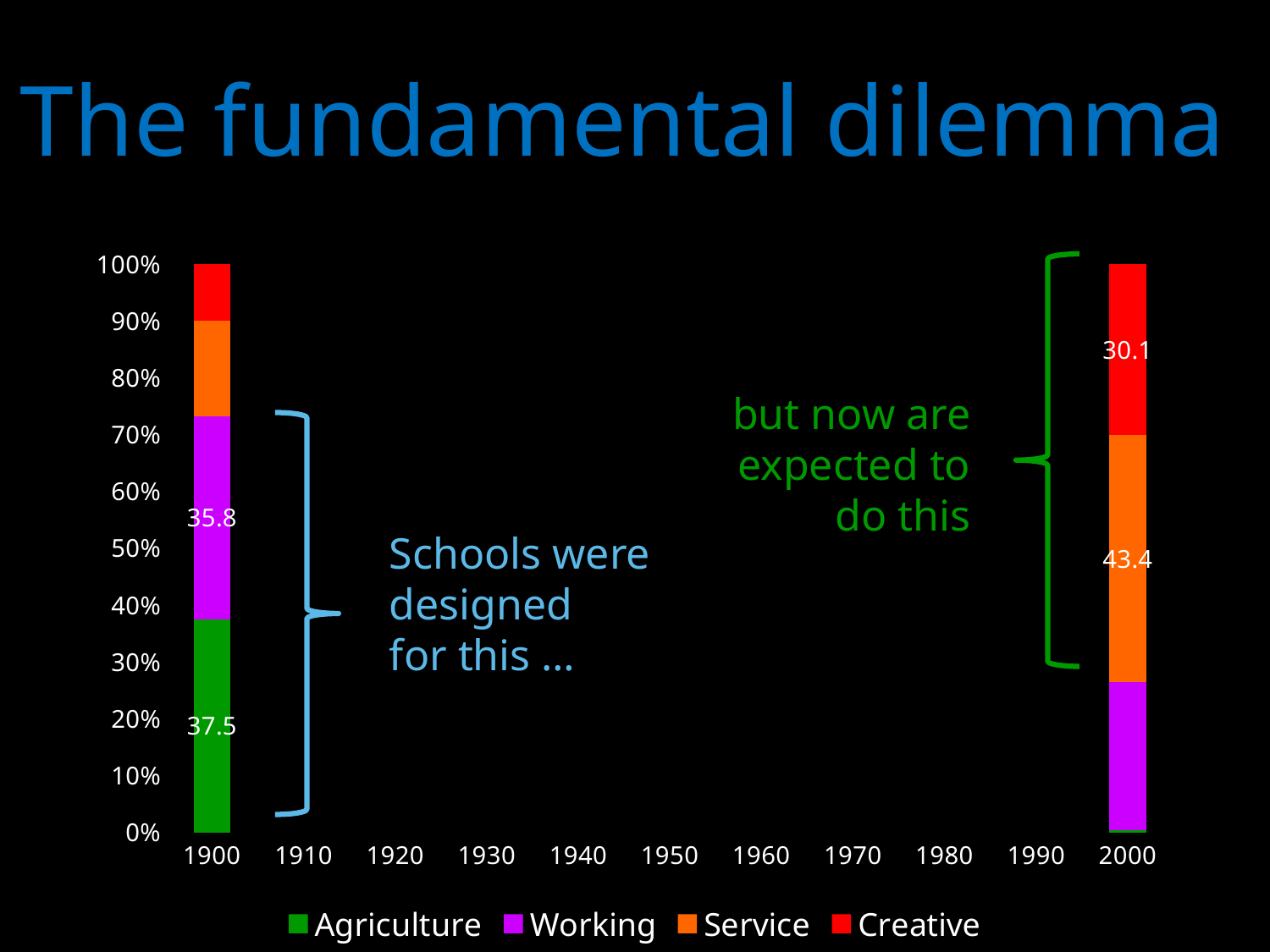
In 2000, which is larger, Service or Creative? Service Is the value for Agriculture in 2000 greater or less than 10%? less What is the value for Service in 2000? 43.4 What is the difference between Service and Creative in 2000? 13.3 What kind of chart is shown on the slide? Stacked bar chart Does the Agriculture share rise or fall from 1900 to 2000? Fall What is the value for Agriculture in 1900? 37.5 What is the value for Working in 1900? 35.8 What is the value for Creative in 2000? 30.1 What is the difference between Agriculture and Working in 1900? 1.7 How many series does the legend list? 4 How many bars are plotted on the chart? 2